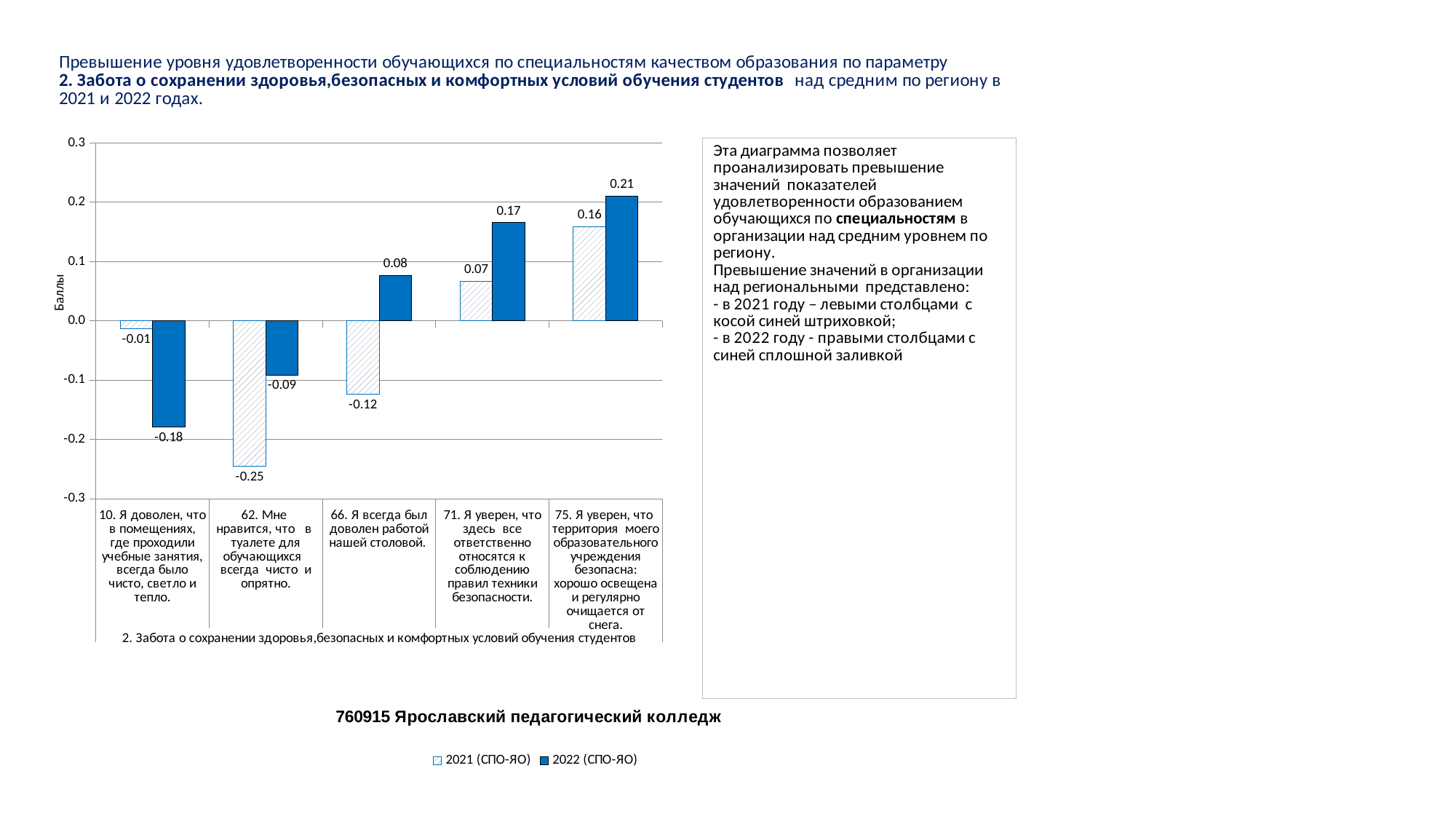
What is the 2022 (СПО-ЯО) value for statement 75 (territory of the educational institution is safe)? 0.21 How many categories (statements) are shown on the x axis? 5 What is the difference between the 2022 and 2021 values for statement 71 (rules of safety are followed responsibly)? 0.10 What type of chart is shown on the slide? bar chart Which statement has the highest 2022 (СПО-ЯО) value? 75. Я уверен, что территория моего образовательного учреждения безопасна: хорошо освещена и регулярно очищается от снега. What is the label of the y axis? Баллы Which statement has the lowest 2021 (СПО-ЯО) value? 62. Мне нравится, что в туалете для обучающихся всегда чисто и опрятно. What is the 2021 (СПО-ЯО) value for statement 62 (toilet is always clean and tidy)? -0.25 What is the 2022 (СПО-ЯО) value for statement 10 (rooms are always clean, bright and warm)? -0.18 For statement 10, which is larger: the 2021 (СПО-ЯО) value or the 2022 (СПО-ЯО) value? 2021 (СПО-ЯО) What is the 2021 (СПО-ЯО) value for statement 66 (satisfied with the canteen)? -0.12 How many series does the legend list? 2